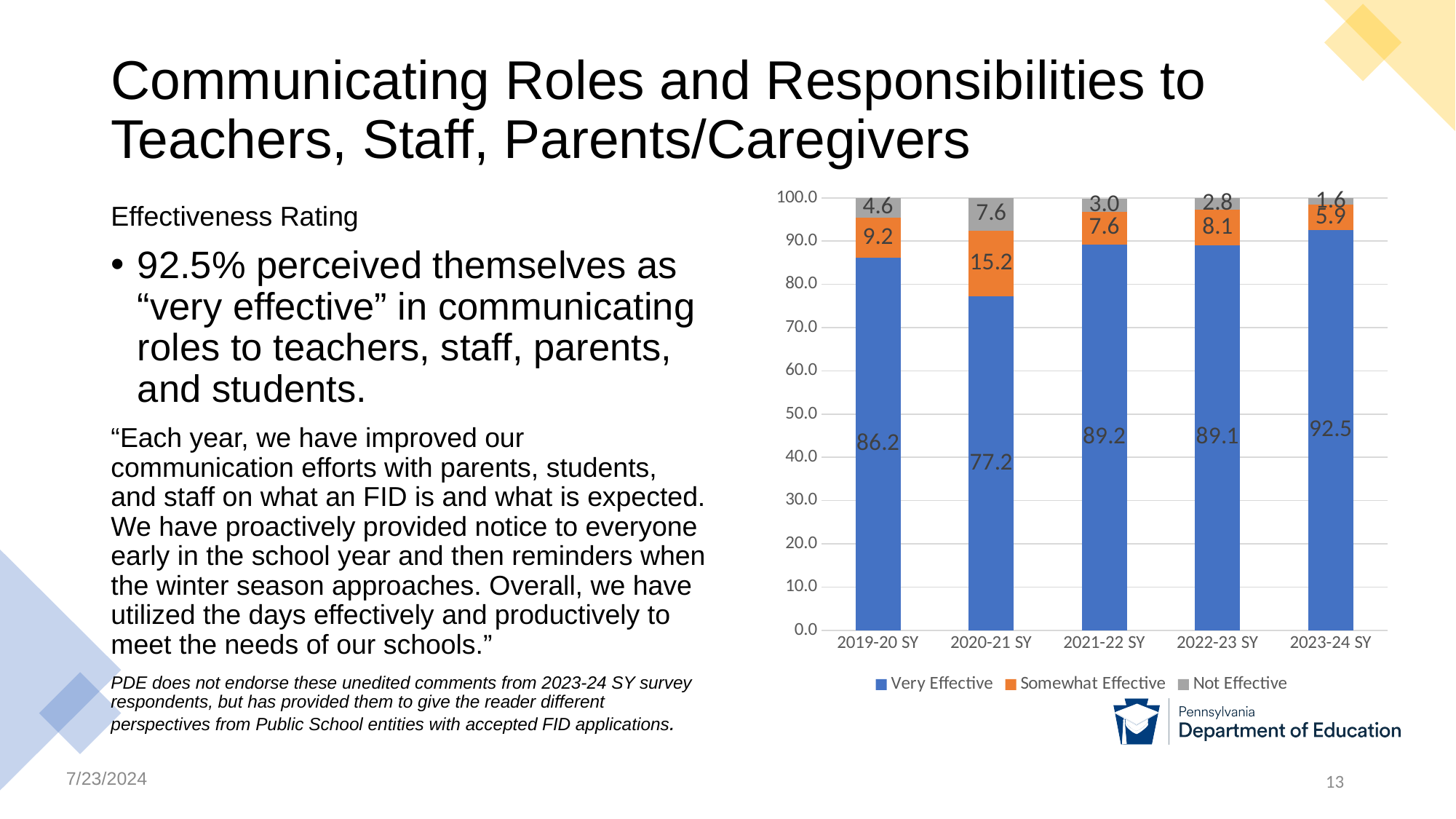
What is the Not Effective value for 2023-24 SY? 1.6 How many series does the legend list? 3 How many school years are shown on the x axis? 5 What is the Very Effective value for 2020-21 SY? 77.2 What kind of chart is shown on the slide? Stacked bar chart Which is larger, the Somewhat Effective value for 2020-21 SY or for 2022-23 SY? 2020-21 SY What is the difference between the Very Effective values for 2023-24 SY and 2019-20 SY? 6.3 What is the Somewhat Effective value for 2019-20 SY? 9.2 Which colour represents the Not Effective series in the chart? Grey What is the total of the stacked bar for 2021-22 SY? 99.8 Which school year has the highest Very Effective value? 2023-24 SY Which school year has the lowest Very Effective value? 2020-21 SY